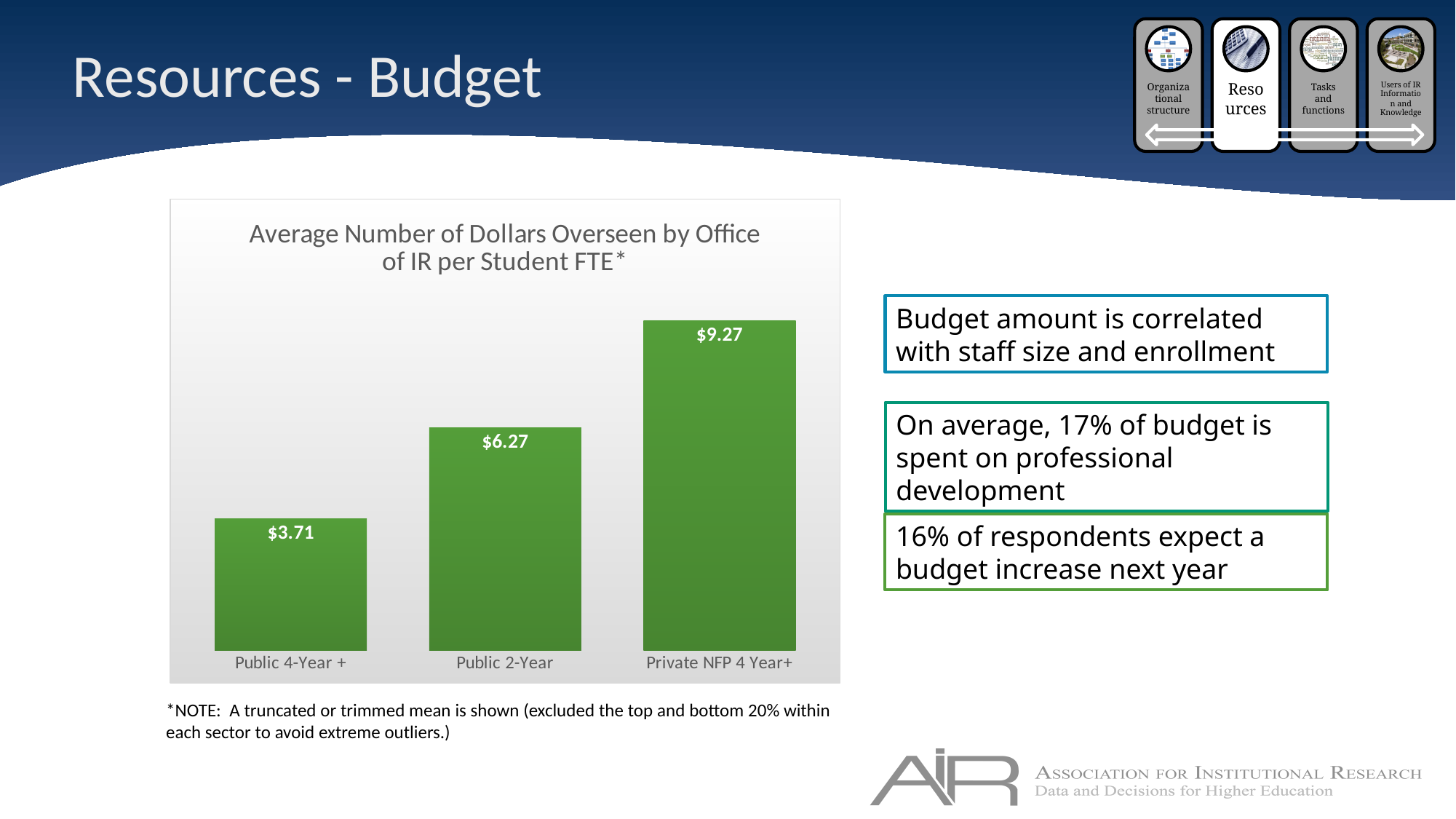
How many categories are shown in the chart? 3 What is the value for Private NFP 4 Year+ in the chart? $9.27 What is the value for Public 2-Year in the chart? $6.27 Which is larger, the value for Public 2-Year or the value for Public 4-Year +? Public 2-Year Which category has the highest average number of dollars overseen per student FTE? Private NFP 4 Year+ What is the title of the chart? Average Number of Dollars Overseen by Office of IR per Student FTE* Do the values rise or fall from left to right across the categories? Rise What is the difference between the values for Public 2-Year and Public 4-Year +? $2.56 Which category has the lowest average number of dollars overseen per student FTE? Public 4-Year + What kind of chart is shown on the slide? Bar chart What is the difference between the values for Private NFP 4 Year+ and Public 4-Year +? $5.56 What is the value for Public 4-Year + in the chart? $3.71